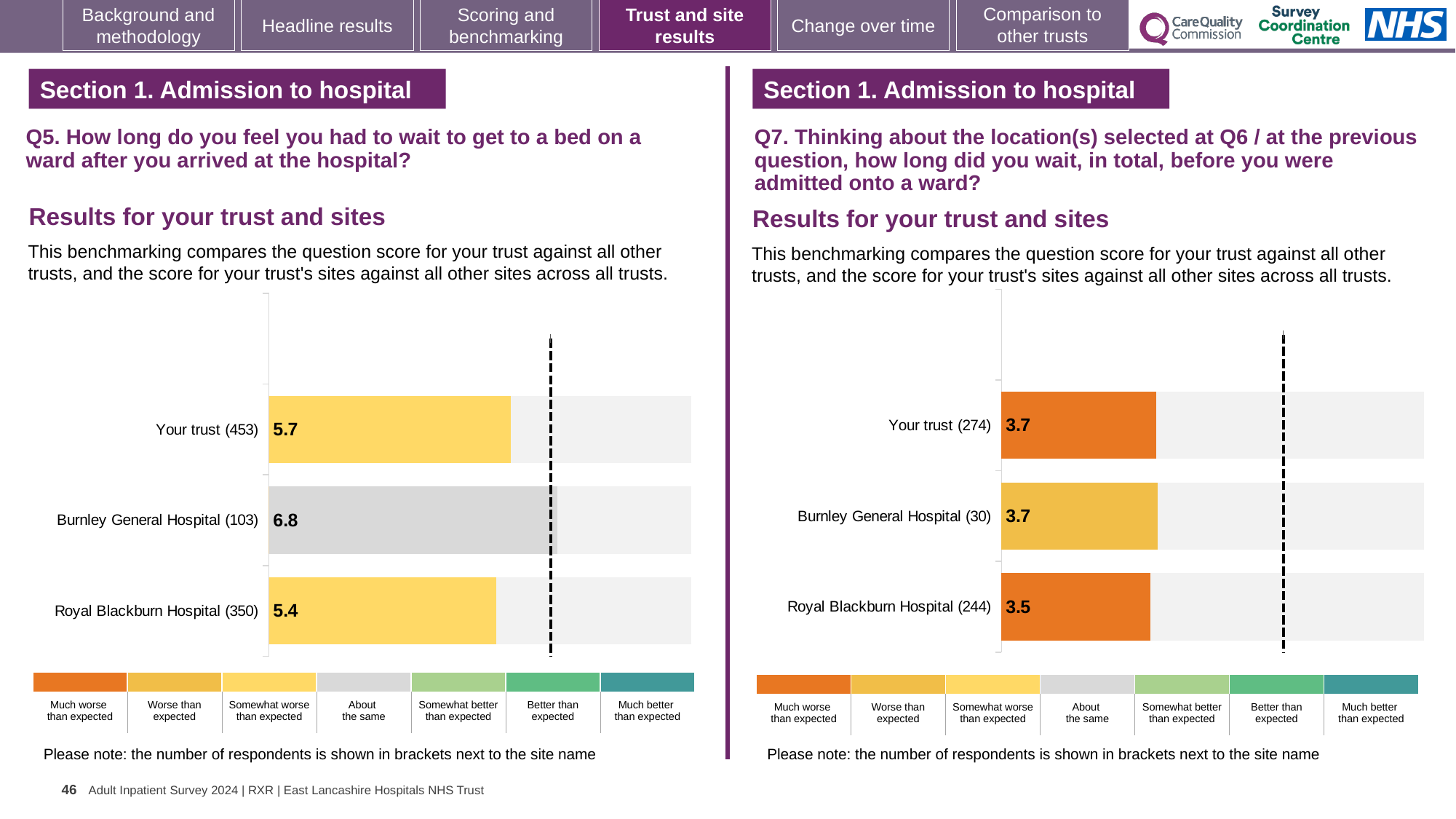
In the Q7 chart on the right, what is the score for Your trust (274)? 3.7 In the Q7 chart on the right, what is the difference between the scores for Burnley General Hospital and Royal Blackburn Hospital? 0.2 How many bars are plotted in the Q5 chart on the left? 3 In the Q5 chart on the left, what is the score for Your trust (453)? 5.7 In the Q5 chart on the left, what is the score for Royal Blackburn Hospital (350)? 5.4 In the Q5 chart on the left, what is the difference between the scores for Burnley General Hospital and Royal Blackburn Hospital? 1.4 In the Q7 chart on the right, which site or trust has the lowest score? Royal Blackburn Hospital (244) What type of chart is used for the Q7 results on the right? Bar chart In the Q5 chart on the left, what is the score for Burnley General Hospital (103)? 6.8 In the Q5 chart on the left, which site or trust has the highest score? Burnley General Hospital (103) In the Q5 chart on the left, which site or trust has the lowest score? Royal Blackburn Hospital (350) In the Q7 chart on the right, what is the score for Royal Blackburn Hospital (244)? 3.5